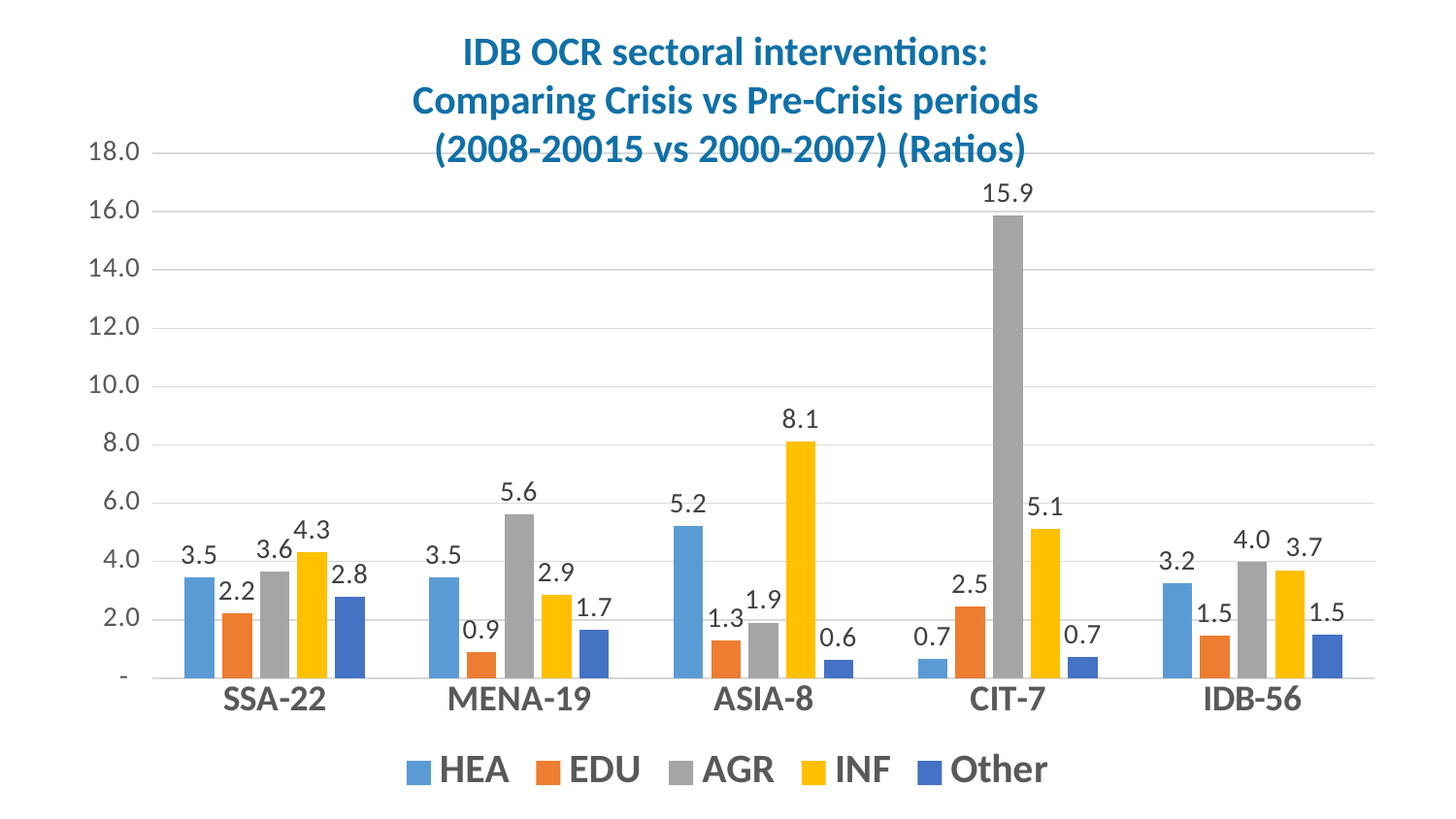
What is the AGR value for CIT-7? 15.9 What kind of chart is shown on the slide? Bar chart What is the Other value for IDB-56? 1.5 How many categories are shown on the x axis? 5 What is the EDU value for MENA-19? 0.9 Which series is shown in yellow in the legend? INF What is the difference between the INF value for ASIA-8 and the INF value for SSA-22? 3.8 Which category has the lowest HEA value? CIT-7 What is the INF value for ASIA-8? 8.1 Which category has the highest AGR value? CIT-7 How many series does the legend list? 5 Which is larger, the HEA value for ASIA-8 or the HEA value for IDB-56? ASIA-8